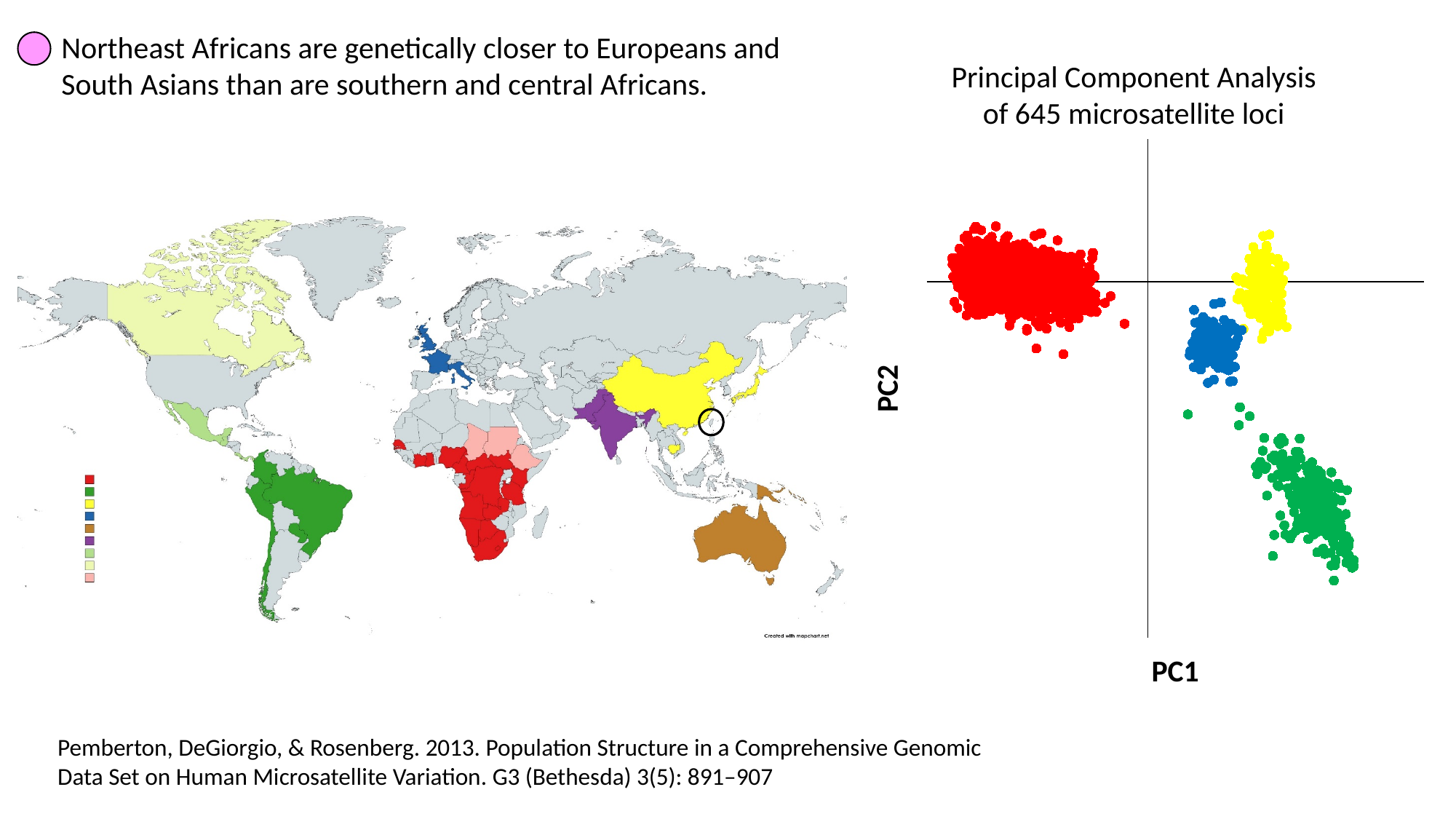
In the Principal Component Analysis chart, which coloured cluster lies furthest to the left along PC1? red In the Principal Component Analysis chart, which coloured cluster lies furthest to the right along PC1? green In the Principal Component Analysis chart, which coloured cluster lies entirely to the left of the vertical PC2 axis line? red What is the label of the horizontal axis of the Principal Component Analysis chart? PC1 In the Principal Component Analysis chart, which cluster is lower along PC2, the red cluster or the blue cluster? blue In the Principal Component Analysis chart, how many coloured clusters lie to the right of the vertical PC2 axis line? 3 In the Principal Component Analysis chart, which cluster is further right along PC1, the blue cluster or the yellow cluster? yellow How many differently coloured clusters of points are plotted in the Principal Component Analysis chart? 4 In the Principal Component Analysis chart, which cluster is higher along PC2, the blue cluster or the green cluster? blue What is the title of the chart on the right of the slide? Principal Component Analysis of 645 microsatellite loci In the Principal Component Analysis chart, which coloured cluster lies lowest along PC2? green What kind of chart is the Principal Component Analysis chart on the right of the slide? scatter plot